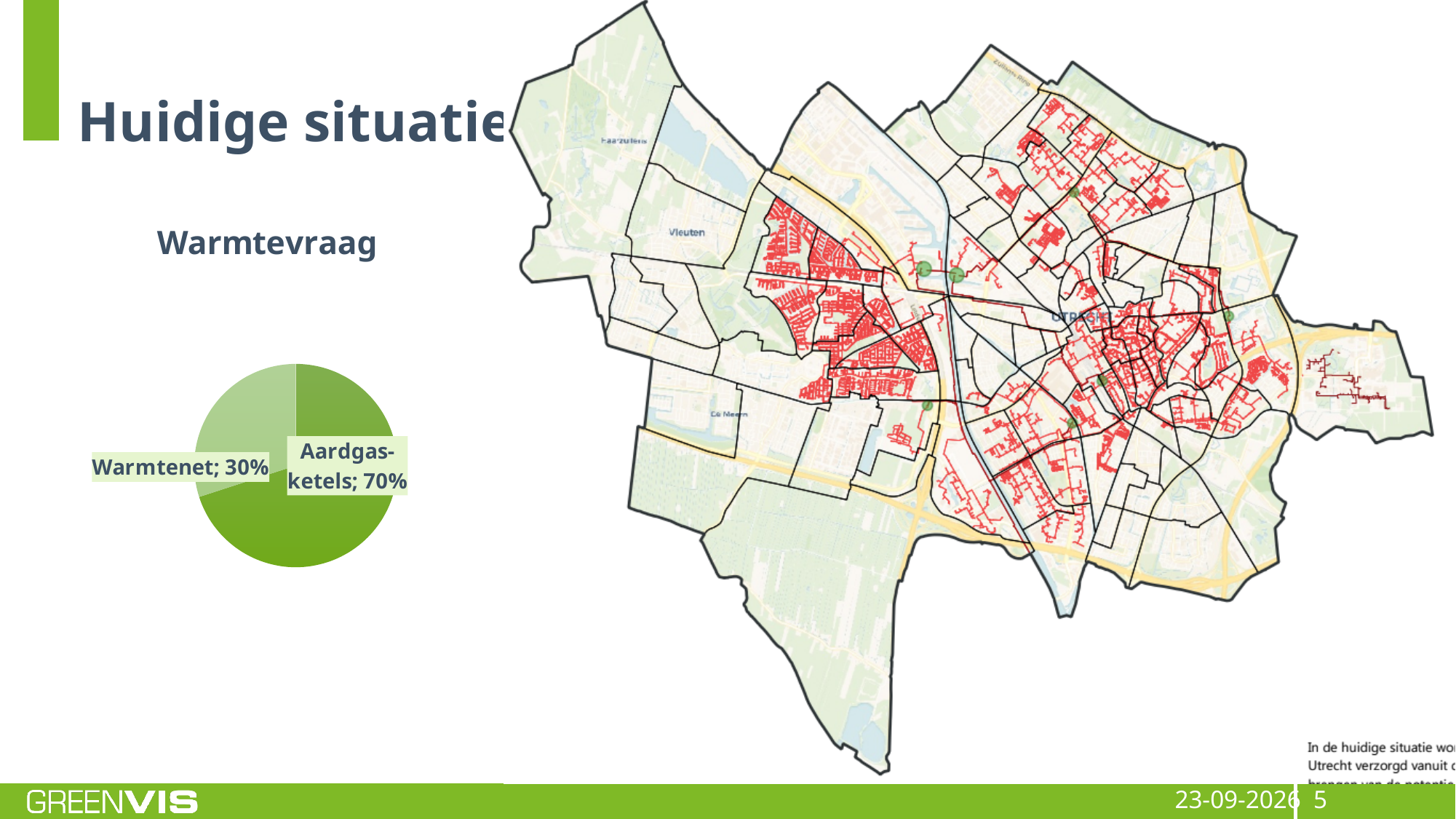
What share of the pie chart is labelled "Warmtenet"? 30% What is the title of the pie chart on the slide? Warmtevraag What is the combined share of Warmtenet and Aardgasketels in the pie chart? 100% In the pie chart, which is larger: Warmtenet or Aardgasketels? Aardgasketels Which slice of the pie chart is the smallest? Warmtenet What kind of chart is shown under the heading "Warmtevraag"? pie chart Which slice of the pie chart is the largest? Aardgasketels How many slices does the pie chart have? 2 By how many percentage points does the Aardgasketels share exceed the Warmtenet share in the pie chart? 40 percentage points What colour is the Aardgasketels slice in the pie chart? green What share of the pie chart is labelled "Aardgasketels"? 70% Is the Warmtenet share in the pie chart greater or less than 50%? less